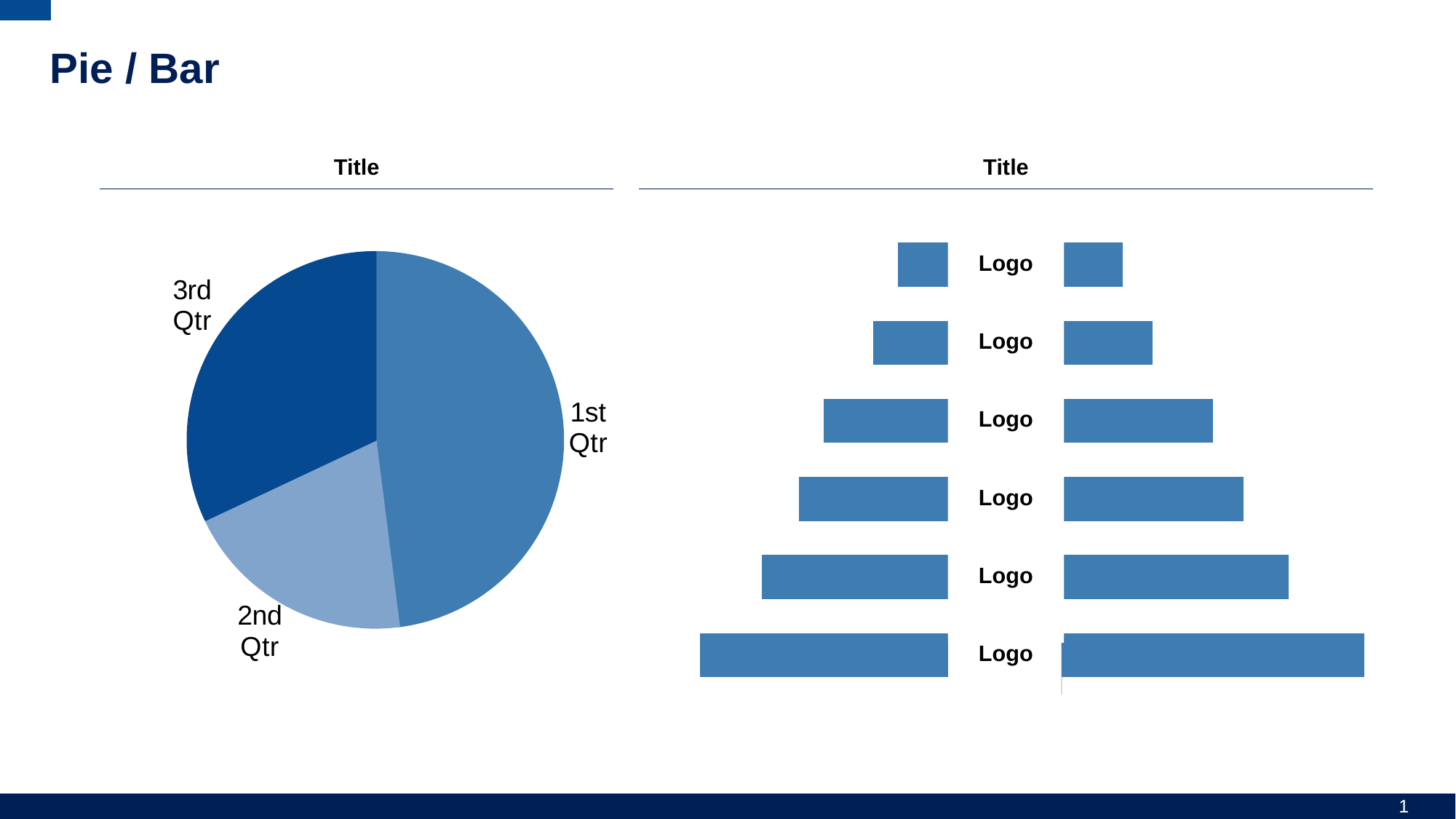
How many slices does the pie chart on the left have? 3 What kind of chart is on the right side of the slide? bar chart In the pie chart on the left, which slice is larger, 1st Qtr or 3rd Qtr? 1st Qtr What is the title shown above the pie chart on the left? Title What kind of chart is on the left side of the slide? pie chart Which slice of the pie chart on the left is the largest? 1st Qtr In the pie chart on the left, which slice is larger, 2nd Qtr or 3rd Qtr? 3rd Qtr In the bar chart on the right, do the bars get longer or shorter going from the top row to the bottom row? longer What label text appears between the two bars in each row of the bar chart on the right? Logo How many rows of bars does the bar chart on the right have? 6 Which slice of the pie chart on the left is the smallest? 2nd Qtr